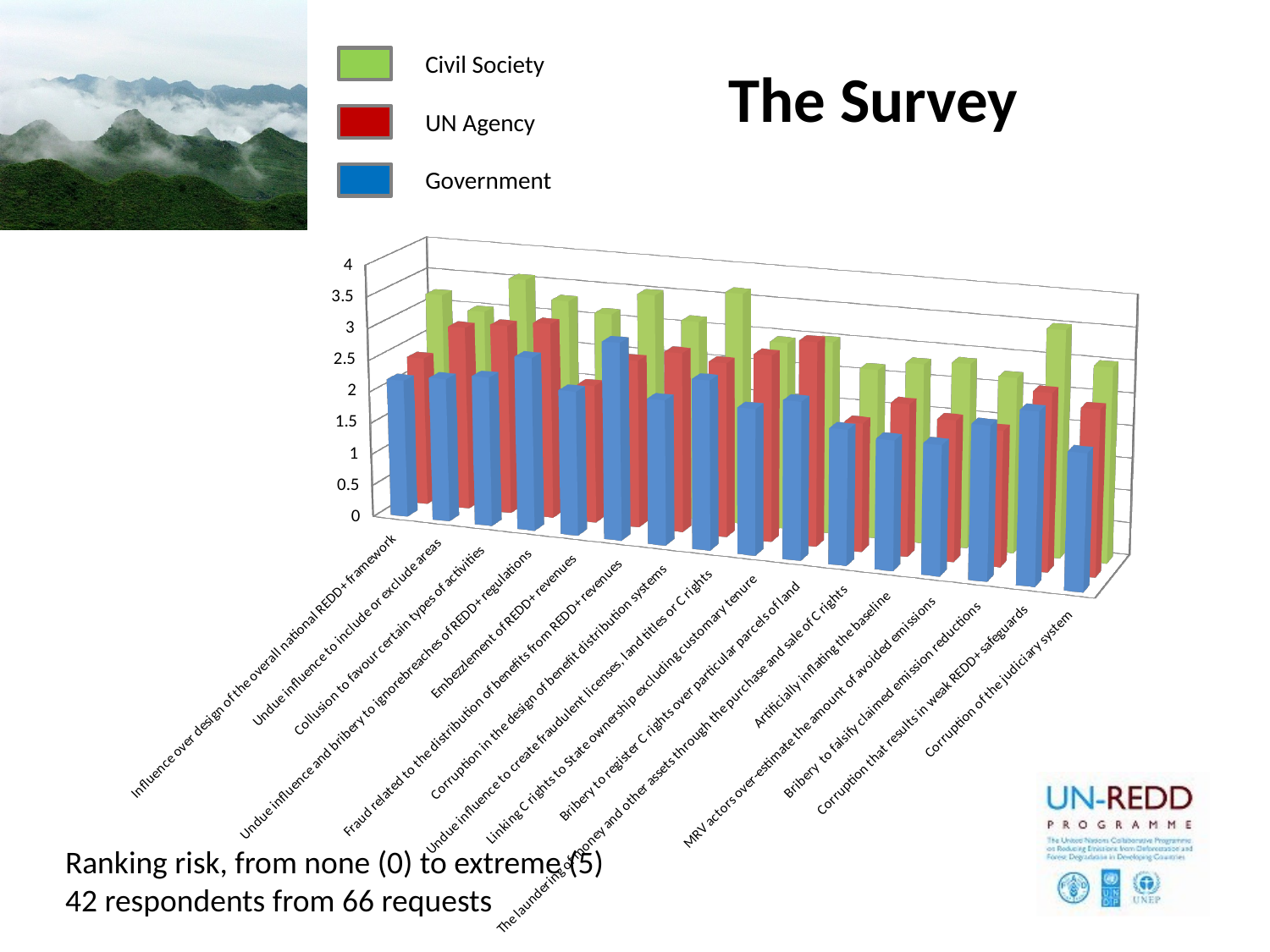
For 'Corruption of the judiciary system', which is larger: the UN Agency value or the Government value? UN Agency How many series does the legend list? 3 For 'Undue influence and bribery to ignore breaches of REDD+ regulations', which is larger: the Civil Society value or the UN Agency value? Civil Society Is the Civil Society value for 'Undue influence and bribery to ignore breaches of REDD+ regulations' greater or less than 3? greater What is the title of the slide containing the chart? The Survey Is the Civil Society value for 'Artificially inflating the baseline' greater or less than 3? less For 'Corruption of the judiciary system', which is larger: the Civil Society value or the Government value? Civil Society What kind of chart is shown on the slide? bar chart Which colour represents the UN Agency series in the legend? red How many risk categories are plotted along the x axis? 16